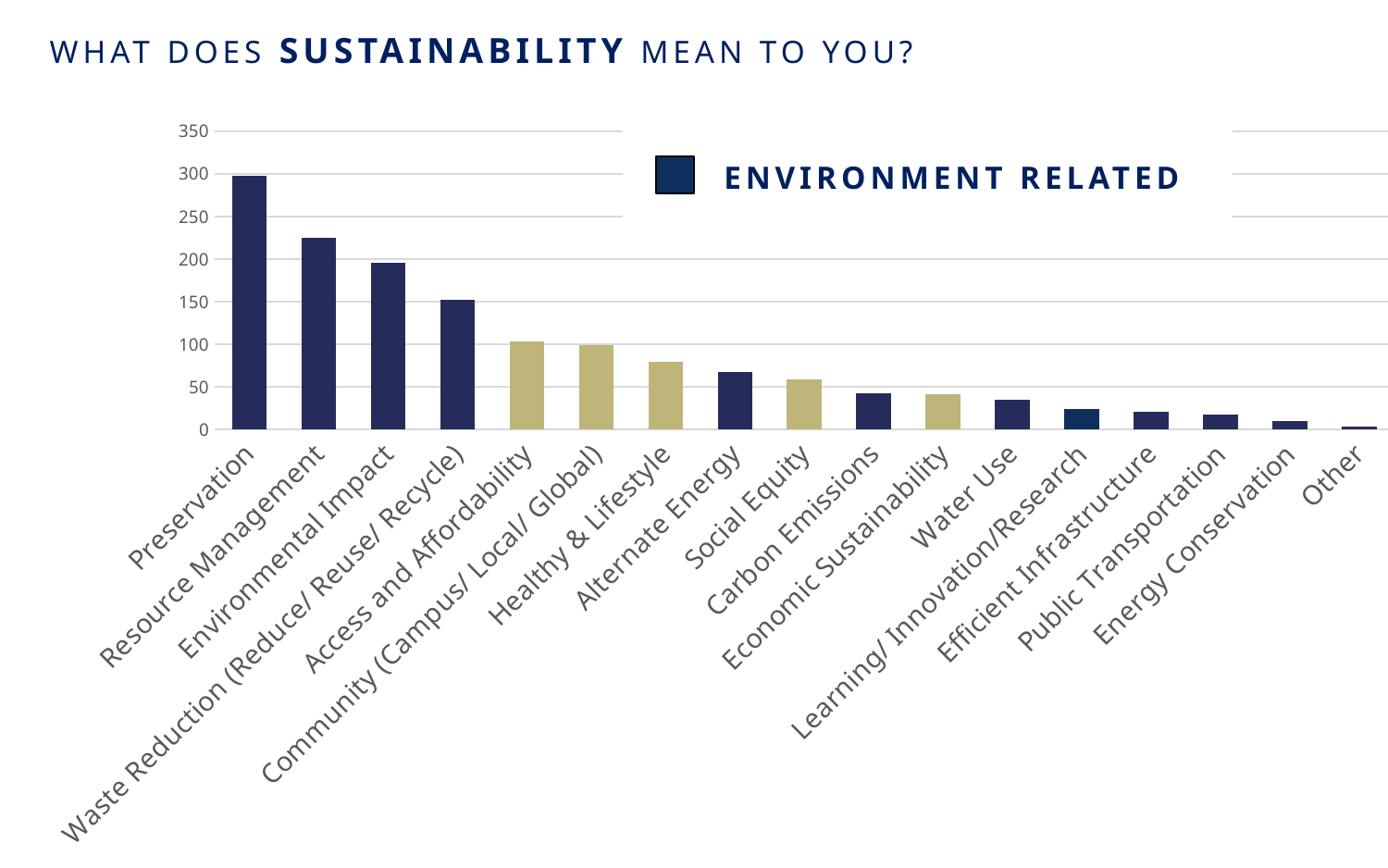
Is the value for Water Use greater or less than 50? less What label does the legend show? Environment Related What kind of chart is shown on the slide? bar chart Which category has the highest value? Preservation Is the value for Waste Reduction (Reduce/ Reuse/ Recycle) greater or less than 100? greater Is the value for Healthy & Lifestyle greater or less than 100? less Do the values rise or fall moving from left to right along the x axis? fall Which category has the lowest value? Other Which is larger, the value for Environmental Impact or the value for Alternate Energy? Environmental Impact How many categories are shown on the x axis? 17